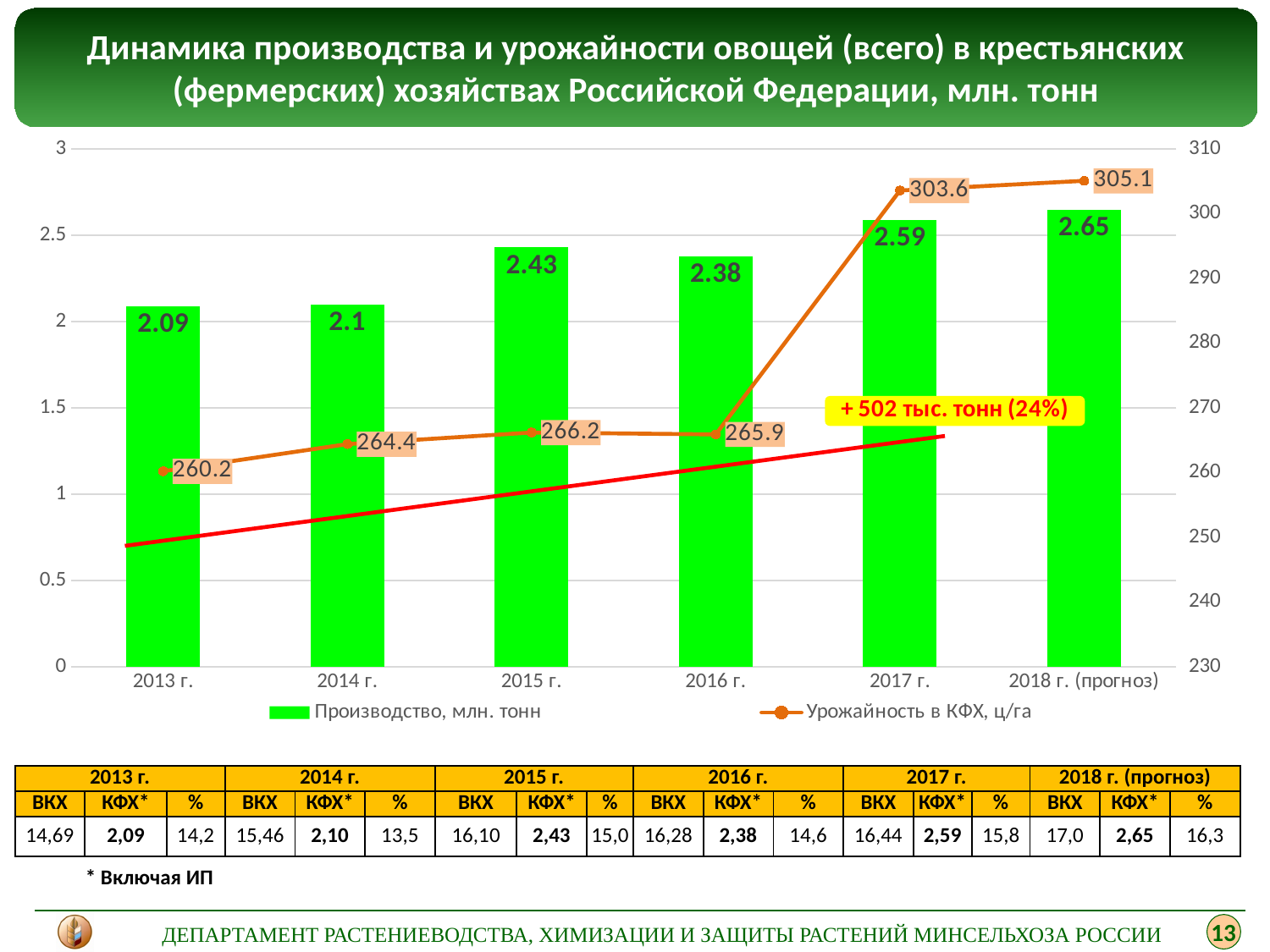
What is the 'Урожайность в КФХ, ц/га' value for 2017 г.? 303.6 How many series does the chart legend list? 2 What is the difference between the 'Производство, млн. тонн' values for 2017 г. and 2016 г.? 0.21 Is the 'Урожайность в КФХ, ц/га' value for 2016 г. greater or less than 270? less Which is larger, the 'Производство, млн. тонн' value for 2015 г. or for 2016 г.? 2015 г. Which year has the highest 'Производство, млн. тонн' bar? 2018 г. (прогноз) What kind of chart is used to show 'Производство, млн. тонн'? bar chart What is the 'Урожайность в КФХ, ц/га' value for 2013 г.? 260.2 Which year has the lowest 'Урожайность в КФХ, ц/га' value? 2013 г. Does the 'Урожайность в КФХ, ц/га' line rise or fall from 2016 г. to 2017 г.? rise What is the value of the 'Производство, млн. тонн' bar for 2015 г.? 2.43 How many years are shown on the x axis of the chart? 6